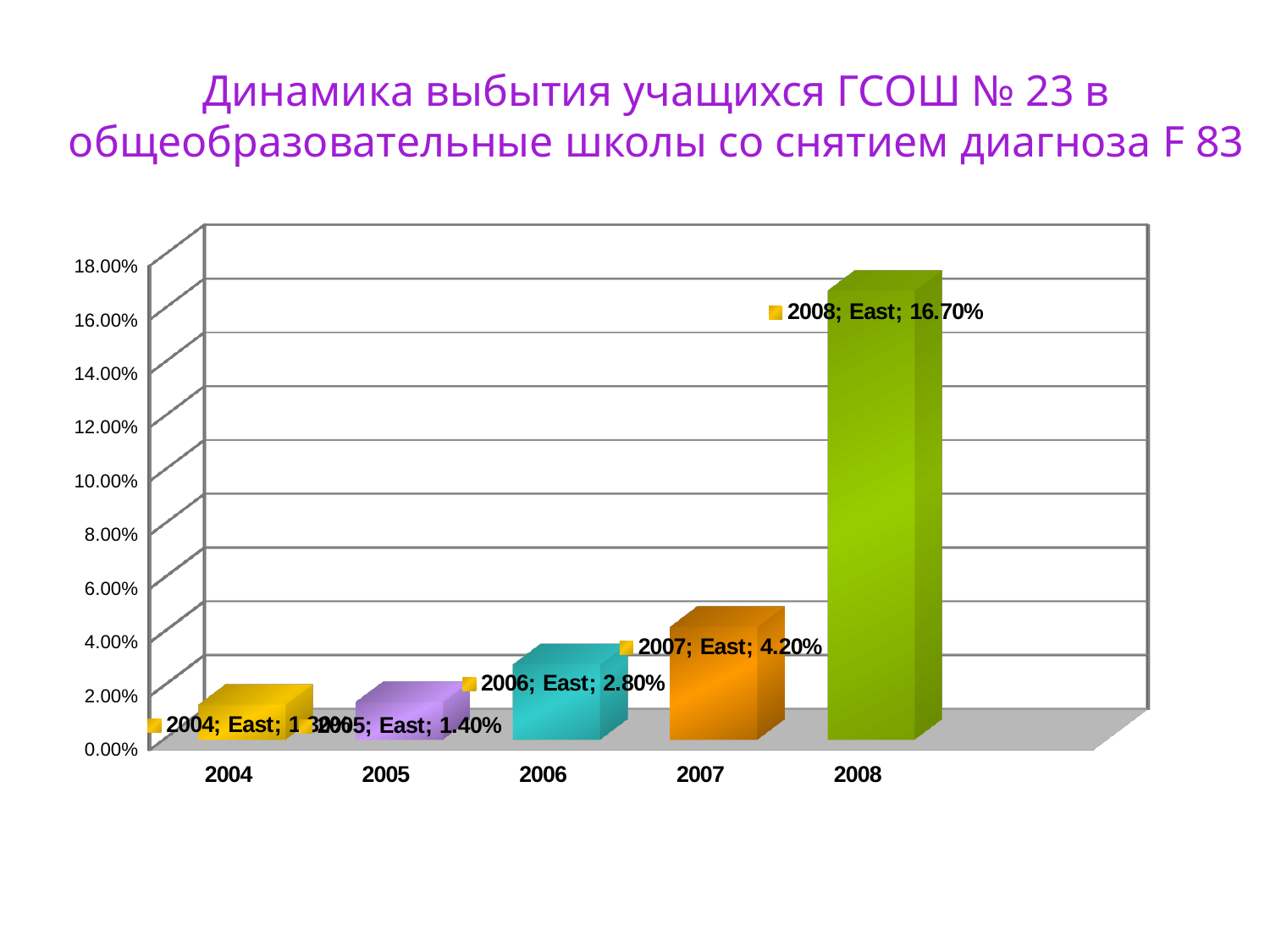
What is the difference between the values for 2008 and 2007? 12.50% What is the value for 2007? 4.20% What is the value for 2006? 2.80% What kind of chart is shown on the slide? bar chart What is the value for 2008? 16.70% How many years are shown on the x axis? 5 Which is larger, the value for 2006 or the value for 2005? 2006 Is the value for 2004 greater or less than 2.00%? less What is the value for 2005? 1.40% What is the difference between the values for 2007 and 2006? 1.40% Which year has the highest value? 2008 Do the values rise or fall from 2004 to 2008? rise